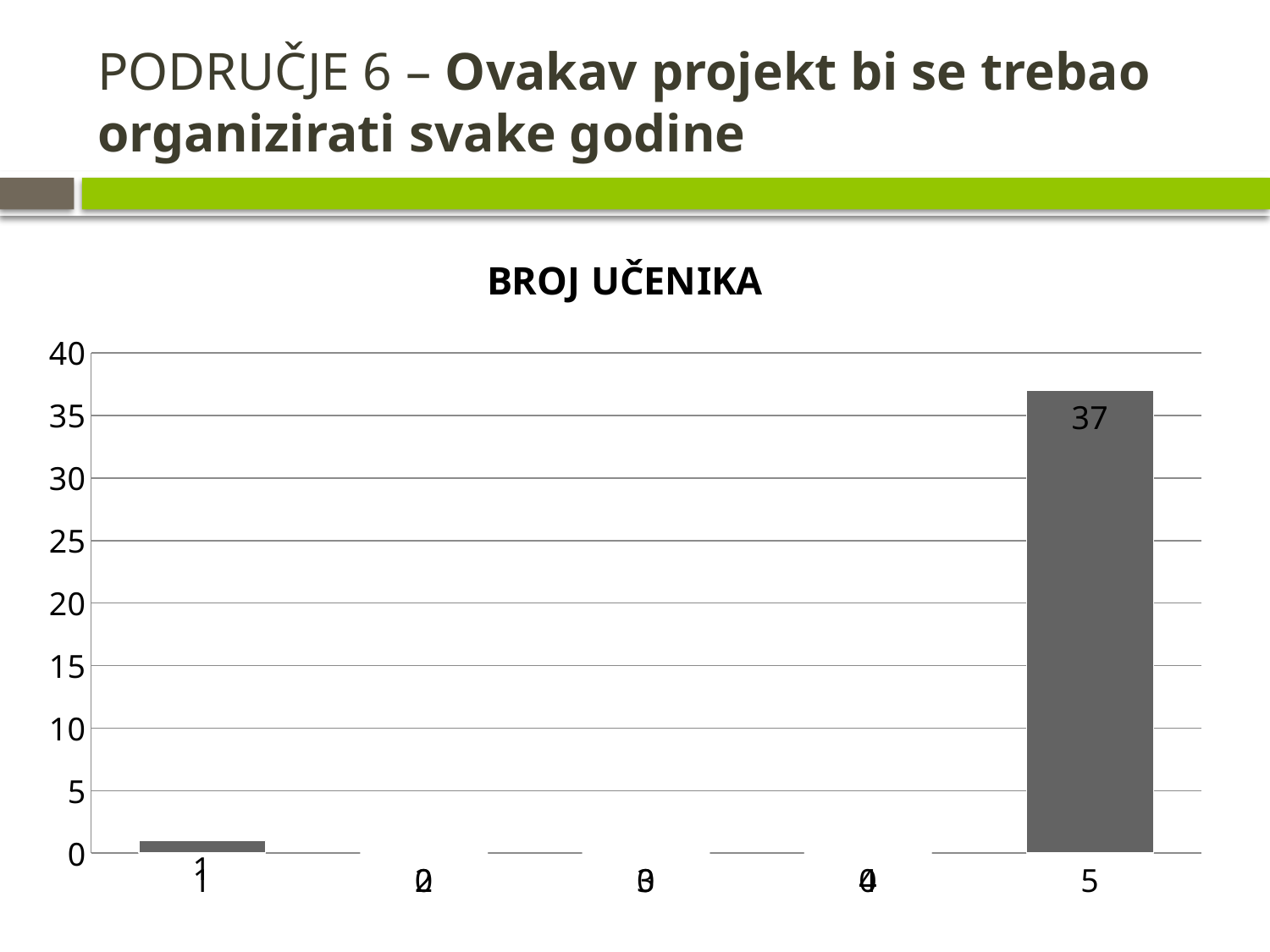
Is the value for category 1 greater or less than 5? less What kind of chart is shown on the slide? bar chart Which is larger, the value for category 5 or the value for category 1? 5 How many categories are shown on the x axis of the BROJ UČENIKA chart? 5 Is the value for category 3 greater or less than 5? less Is the value for category 5 greater or less than 35? greater What is the highest value shown on the y axis of the chart? 40 What is the value for category 5 in the BROJ UČENIKA chart? 37 What is the title of the chart on the slide? BROJ UČENIKA Which category has the highest value in the BROJ UČENIKA chart? 5